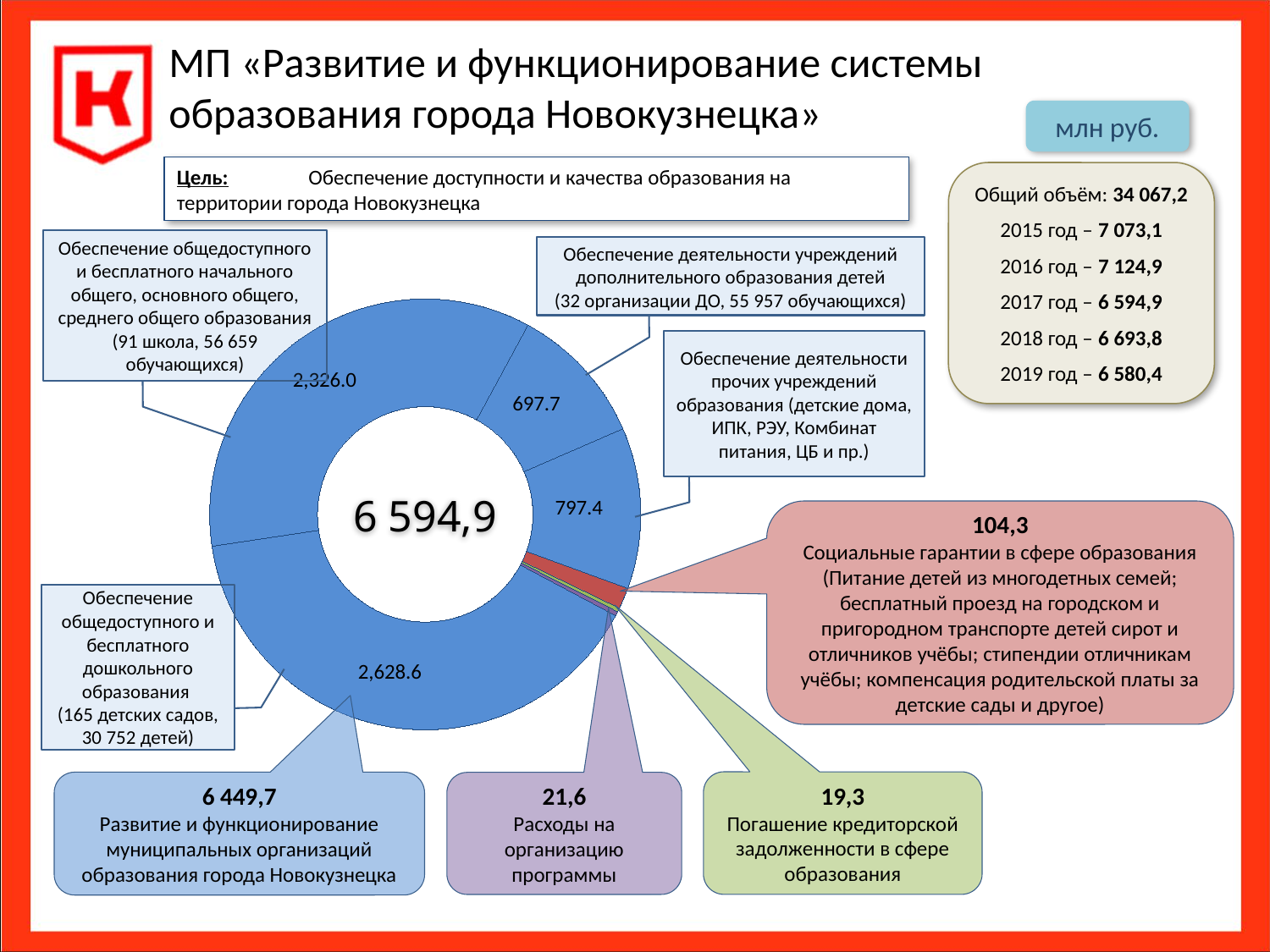
What is the value of the slice for additional education institutions (32 организации ДО)? 697.7 What value is printed in the centre of the doughnut chart? 6 594,9 What kind of chart is shown on the slide? Doughnut (pie) chart What is the value of the slice for other education institutions (детские дома, ИПК, РЭУ и пр.)? 797.4 What unit is indicated for the values on the slide? млн руб. What value is given for the red slice labelled Социальные гарантии в сфере образования? 104,3 What is the value of the slice for preschool education (Обеспечение общедоступного и бесплатного дошкольного образования)? 2,628.6 What is the difference between the preschool education slice (2,628.6) and the general school education slice (2,326.0)? 302.6 Which slice of the doughnut chart has the smallest value? Погашение кредиторской задолженности (19,3) What is the value of the slice for general school education (91 школа, 56 659 обучающихся)? 2,326.0 Which slice of the doughnut chart has the largest value? Preschool education (2,628.6) Which is larger: the slice for other education institutions or the slice for additional education institutions? Other education institutions (797.4)